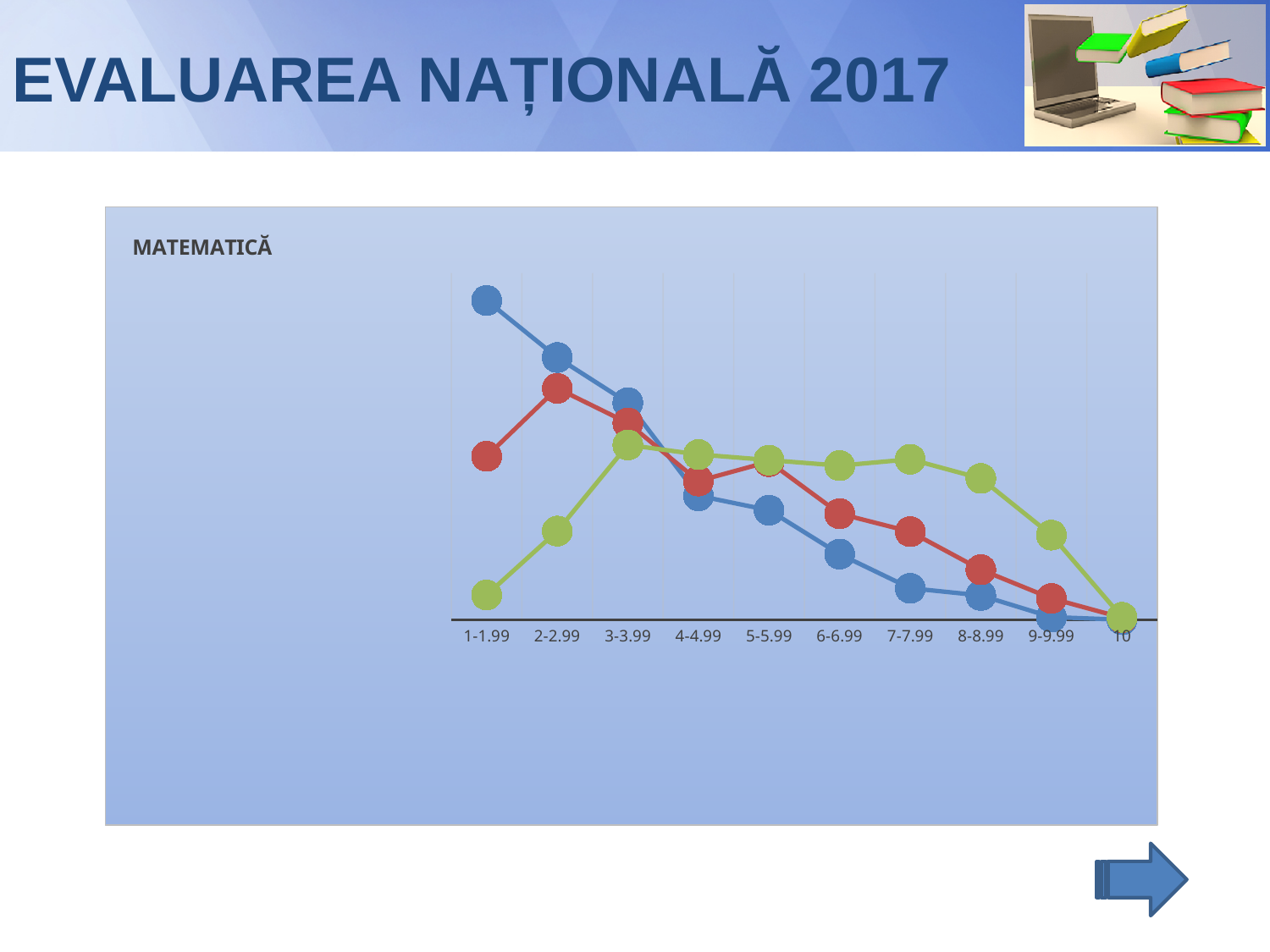
What kind of chart is shown on the slide? line chart How many categories are shown on the x axis of the chart? 10 At 8-8.99, which of the three lines is the highest? green What is the title of the chart? MATEMATICĂ At which category does the red line reach its highest value? 2-2.99 At 1-1.99, which line is higher, the blue line or the green line? blue At which category does the blue line reach its highest value? 1-1.99 How many lines are plotted on the chart? 3 At which category does the green line reach its lowest value? 10 At 7-7.99, which line is higher, the green line or the blue line? green Does the green line rise or fall from 1-1.99 to 3-3.99? rise Does the blue line rise or fall from 1-1.99 to 10? fall